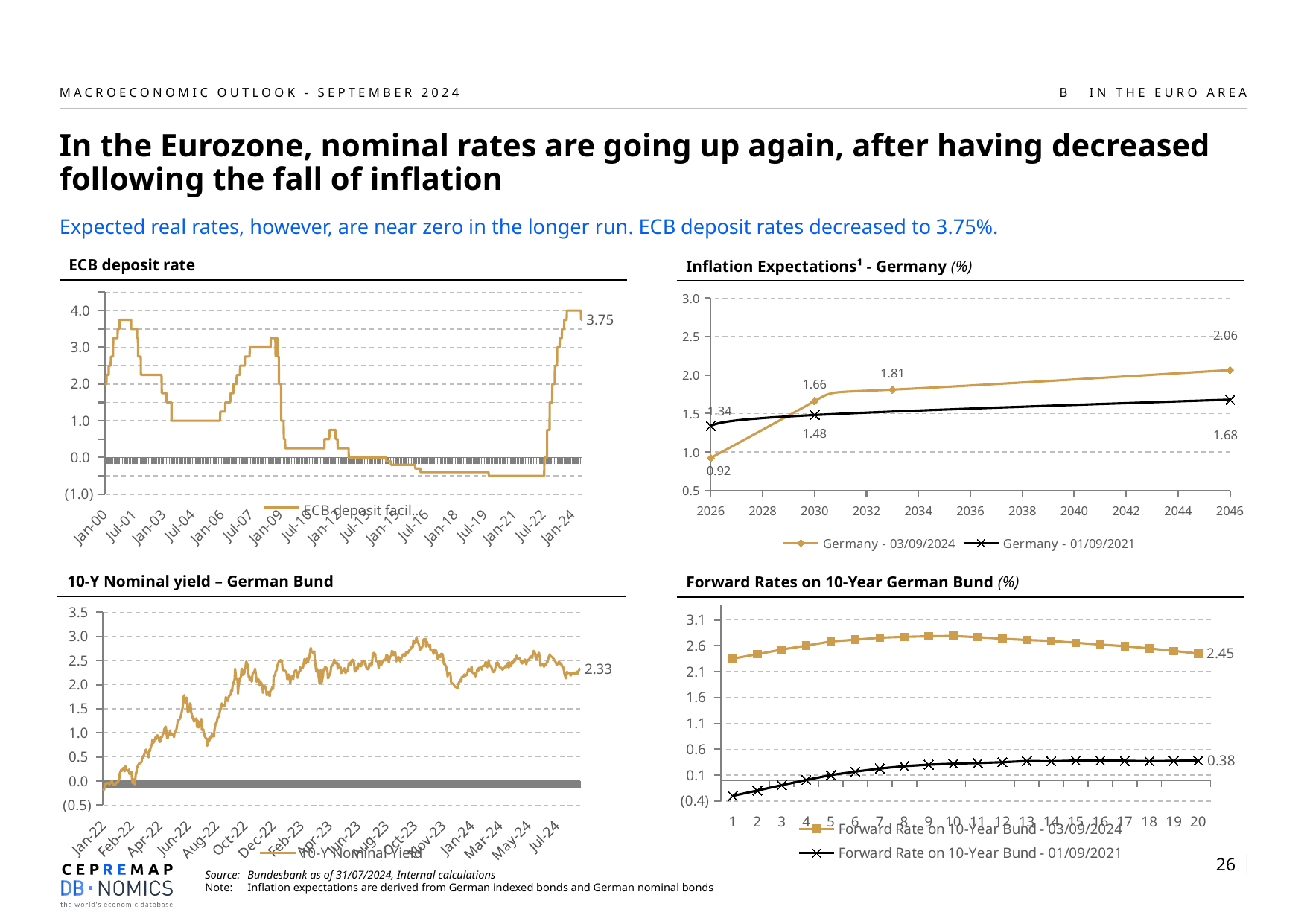
On the Forward Rates on 10-Year German Bund chart, how many points are shown on the x axis? 20 On the Forward Rates on 10-Year German Bund chart, is the value of the 01/09/2021 series at point 1 greater or less than 0.1? less On the Forward Rates on 10-Year German Bund chart, what is the value labelled at the end of the Forward Rate on 10-Year Bund - 03/09/2024 series? 2.45 On the Inflation Expectations - Germany chart, what is the difference between the two series' values in 2046? 0.38 On the Forward Rates on 10-Year German Bund chart, what is the value labelled at the end of the Forward Rate on 10-Year Bund - 01/09/2021 series? 0.38 On the ECB deposit rate chart, what is the latest value labelled at the end of the line? 3.75 On the Inflation Expectations - Germany chart, what is the value of the Germany - 03/09/2024 series in 2026? 0.92 On the 10-Y Nominal yield – German Bund chart, what is the value labelled at the end of the line? 2.33 What kind of chart is the ECB deposit rate chart? line chart On the Inflation Expectations - Germany chart, which series has the higher value in 2026? Germany - 01/09/2021 On the Inflation Expectations - Germany chart, what is the value of the Germany - 01/09/2021 series in 2030? 1.48 On the Inflation Expectations - Germany chart, how many series does the legend list? 2